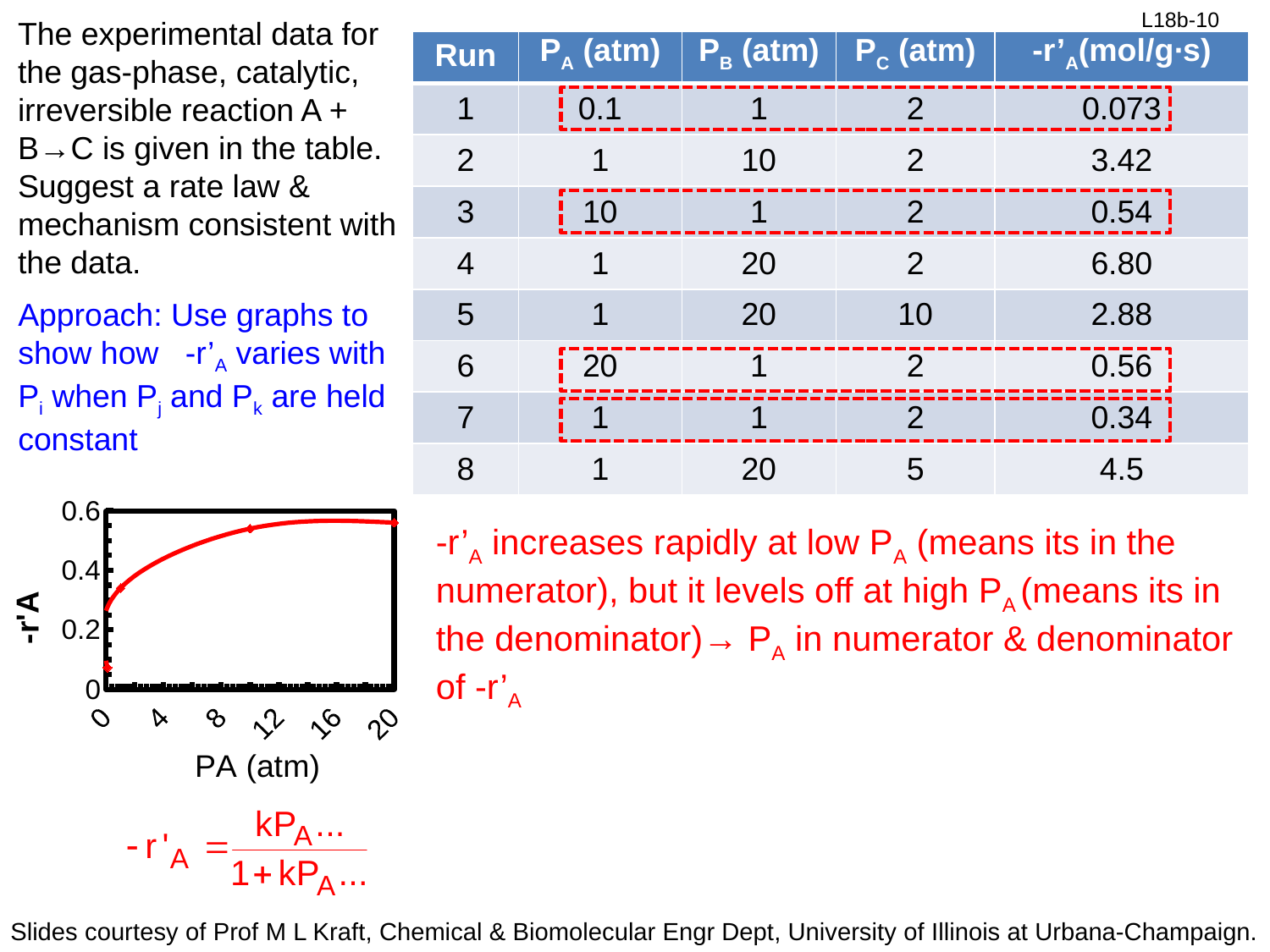
What is the label of the y axis of the chart? -r'A In the chart, is the value of -r'A at the lowest PA (near 0 atm) greater or less than 0.2? less What kind of chart is shown at the bottom left of the slide? line chart How many data points are marked on the line in the chart? 4 Which data point in the chart has the lowest -r'A value: the one at the lowest PA or the one at PA = 20 atm? the one at the lowest PA In the chart, is the value of -r'A at PA = 20 atm greater or less than 0.6? less What is the label of the x axis of the chart? PA (atm) In the chart, is the value of -r'A at PA = 10 atm greater or less than 0.4? greater Does -r'A rise or fall as PA increases along the x axis of the chart? rise What is the highest tick value shown on the x axis of the chart? 20